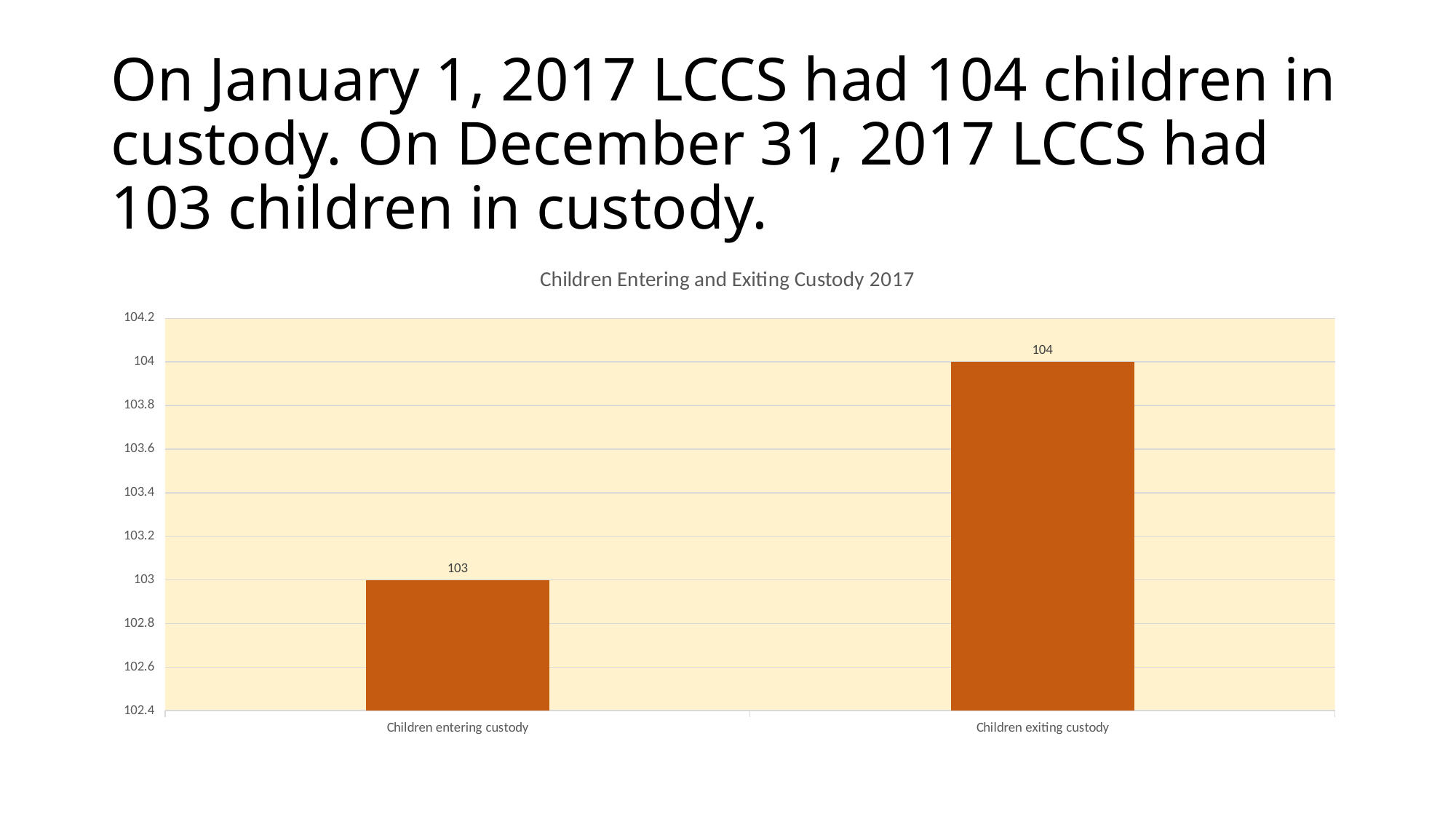
What colour are the bars in the chart? orange Which category has the lowest value? Children entering custody What kind of chart is shown on the slide? bar chart What is the value for Children exiting custody? 104 What is the value for Children entering custody? 103 Is the value for Children exiting custody greater or less than 103.6? greater Which category has the highest value? Children exiting custody What is the title of the chart? Children Entering and Exiting Custody 2017 Which is larger, the value for Children entering custody or Children exiting custody? Children exiting custody Is the value for Children entering custody greater or less than 103.4? less How many categories are shown in the chart? 2 What is the difference between the values for Children exiting custody and Children entering custody? 1